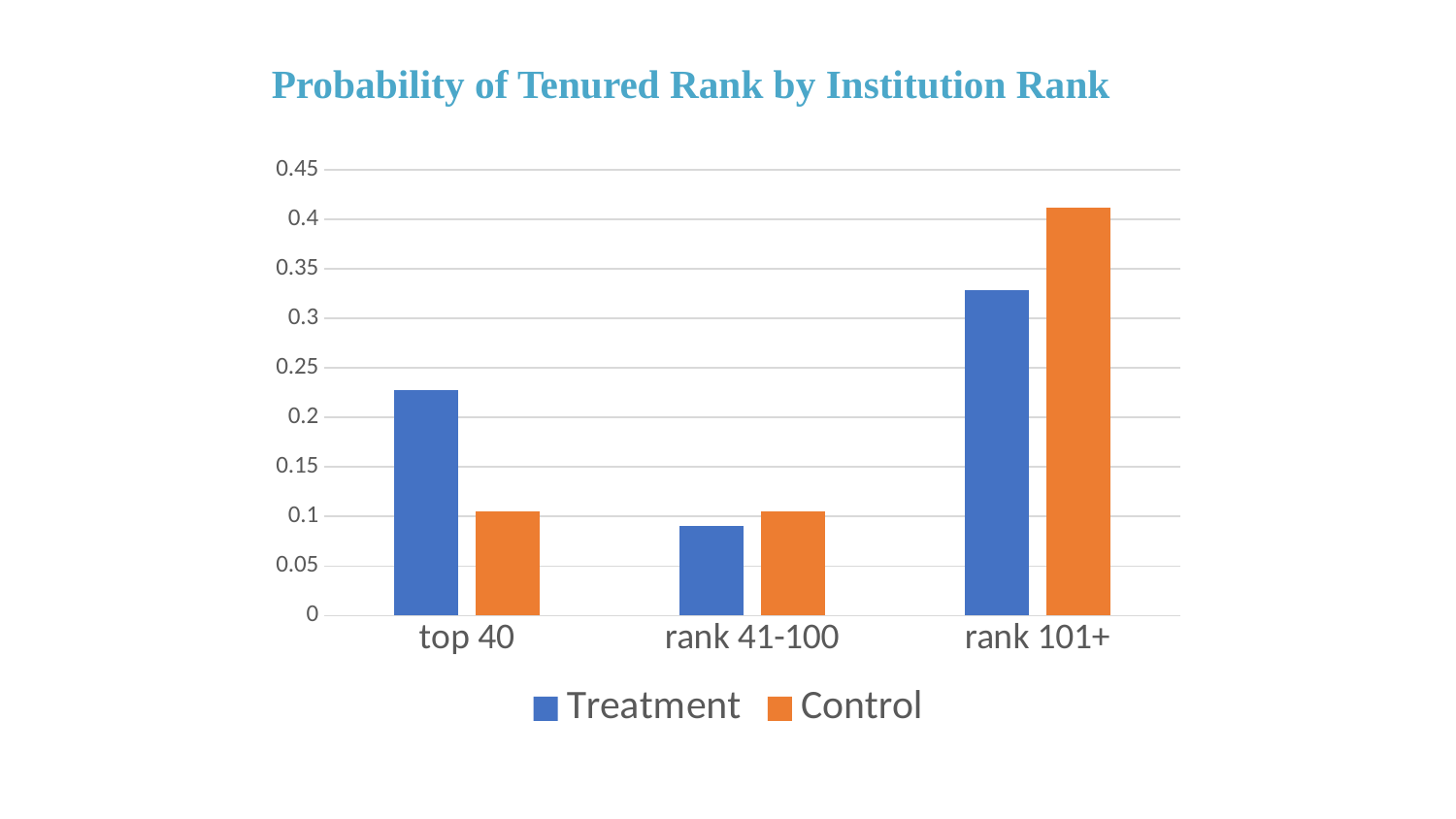
For rank 101+, which is larger, Treatment or Control? Control How many institution rank categories are shown on the x axis? 3 How many series does the legend list? 2 What is the title of the chart? Probability of Tenured Rank by Institution Rank Which category has the lowest Treatment value? rank 41-100 Which category has the highest Treatment value? rank 101+ Which category has the highest Control value? rank 101+ What type of chart is shown on the slide? bar chart Is the Treatment value for top 40 greater or less than 0.2? greater Is the Control value for rank 101+ greater or less than 0.35? greater Is the Treatment value for rank 41-100 greater or less than 0.1? less For top 40, which is larger, Treatment or Control? Treatment